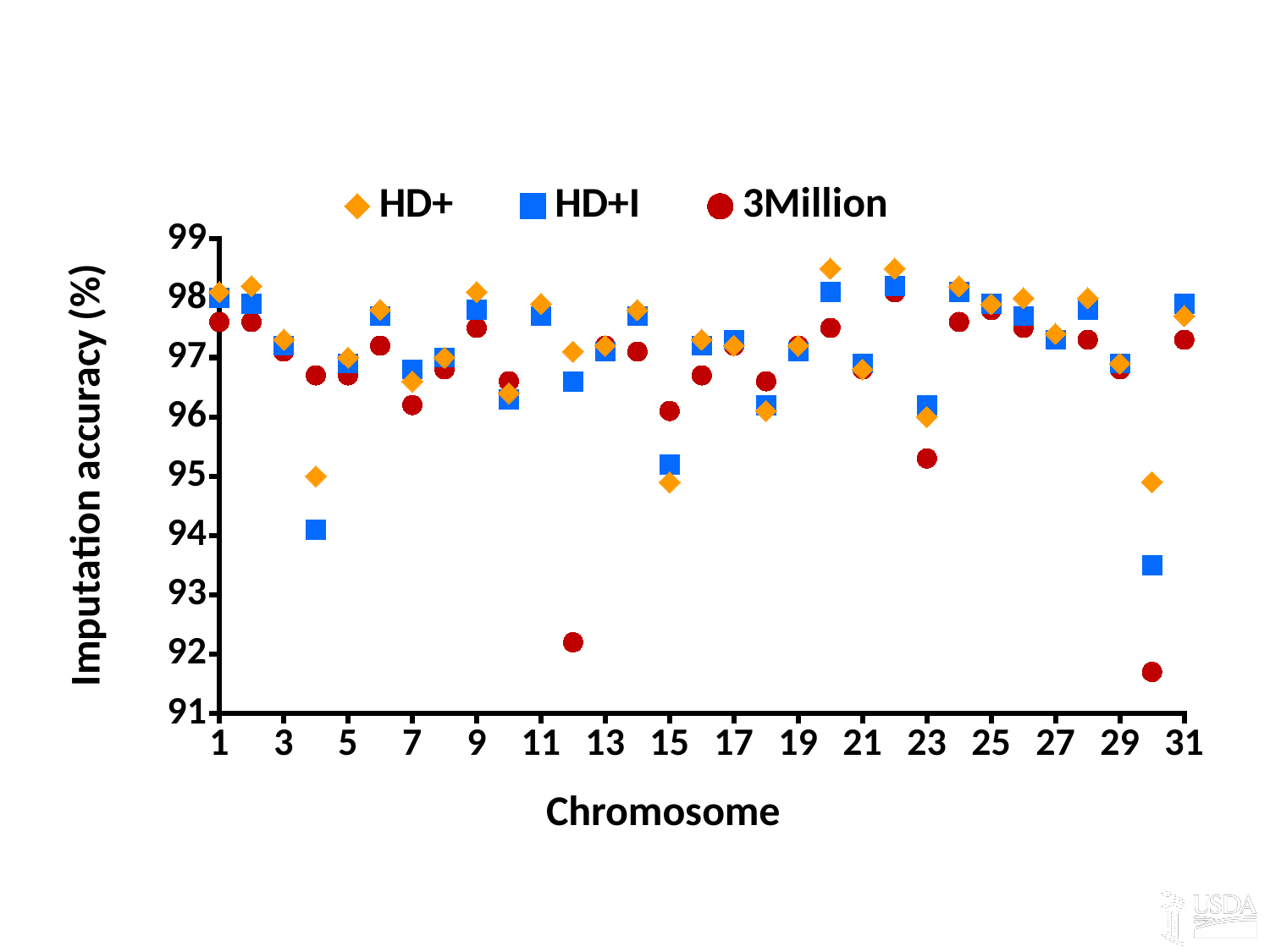
For chromosome 4, which series has the larger value, HD+ or HD+I? HD+ Is the HD+I value for chromosome 4 greater or less than 95? less What is the title of the x axis? Chromosome Is the HD+ value for chromosome 20 greater or less than 98? greater How many series does the legend list? 3 What is the title of the y axis? Imputation accuracy (%) Is the 3Million value for chromosome 12 greater or less than 93? less What kind of chart is shown on the slide? Scatter chart For which chromosome is the 3Million imputation accuracy lowest? 30 How many chromosomes are plotted along the x axis? 31 For chromosome 30, which series has the larger value, HD+ or 3Million? HD+